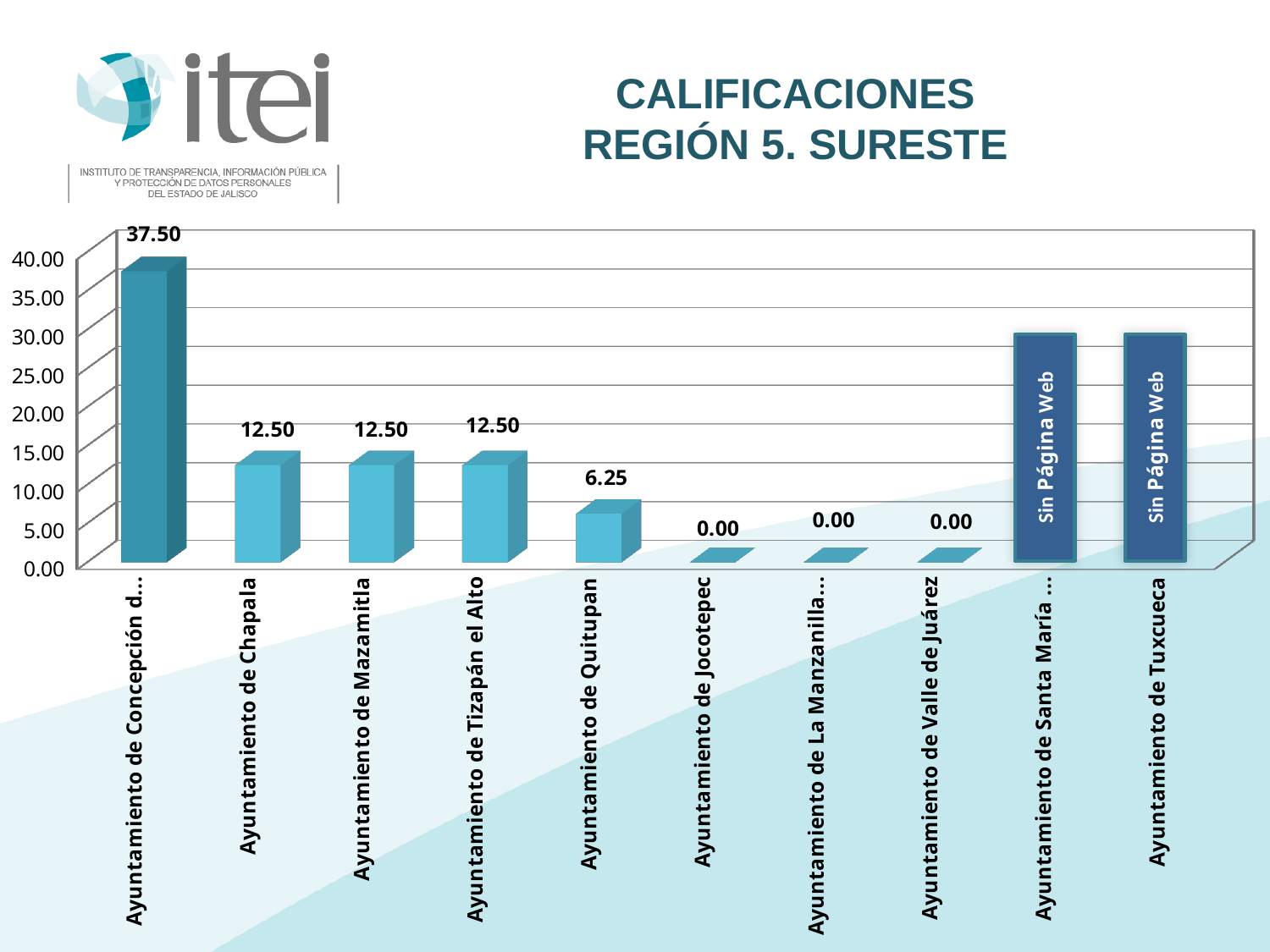
Which is larger, the value for Ayuntamiento de Chapala or the value for Ayuntamiento de Quitupan? Ayuntamiento de Chapala Is the value for the leftmost bar greater or less than 35.00? greater What is the value for Ayuntamiento de Quitupan? 6.25 What is the difference between the value for Ayuntamiento de Mazamitla and the value for Ayuntamiento de Quitupan? 6.25 What is the value shown for the first (leftmost) bar in the chart? 37.50 What kind of chart is shown on the slide? Bar chart What is the title of the slide containing the chart? CALIFICACIONES REGIÓN 5. SURESTE How many categories are shown on the x axis of the chart? 10 What is the value for Ayuntamiento de Jocotepec? 0.00 What is the value for Ayuntamiento de Tizapán el Alto? 12.50 What is the value for Ayuntamiento de Chapala? 12.50 What label is shown in place of a value for Ayuntamiento de Tuxcueca? Sin Página Web